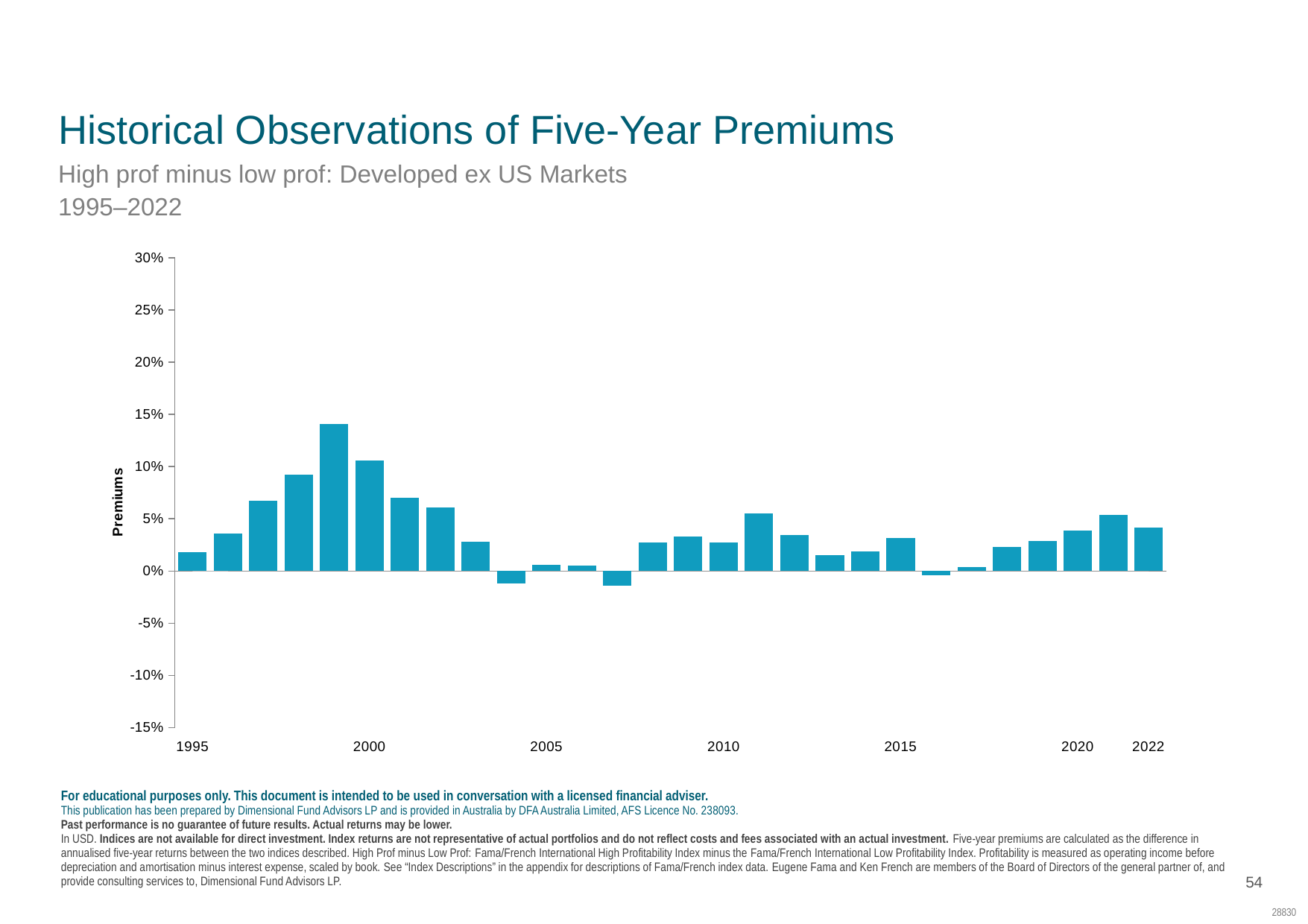
Which is larger, the value for 1999 or the value for 2000? 1999 Is the value for 2004 greater or less than 0%? less Is the value for 1999 greater or less than 10%? greater Is the value for 2013 greater or less than 5%? less Which is larger, the value for 1998 or the value for 2011? 1998 What is the label on the vertical axis of the chart? Premiums Which year has the highest five-year premium in the chart? 1999 What kind of chart is shown on the slide? Bar chart Do the values rise or fall from 1995 to 1999? rise What range of years does the chart's subtitle say it covers? 1995–2022